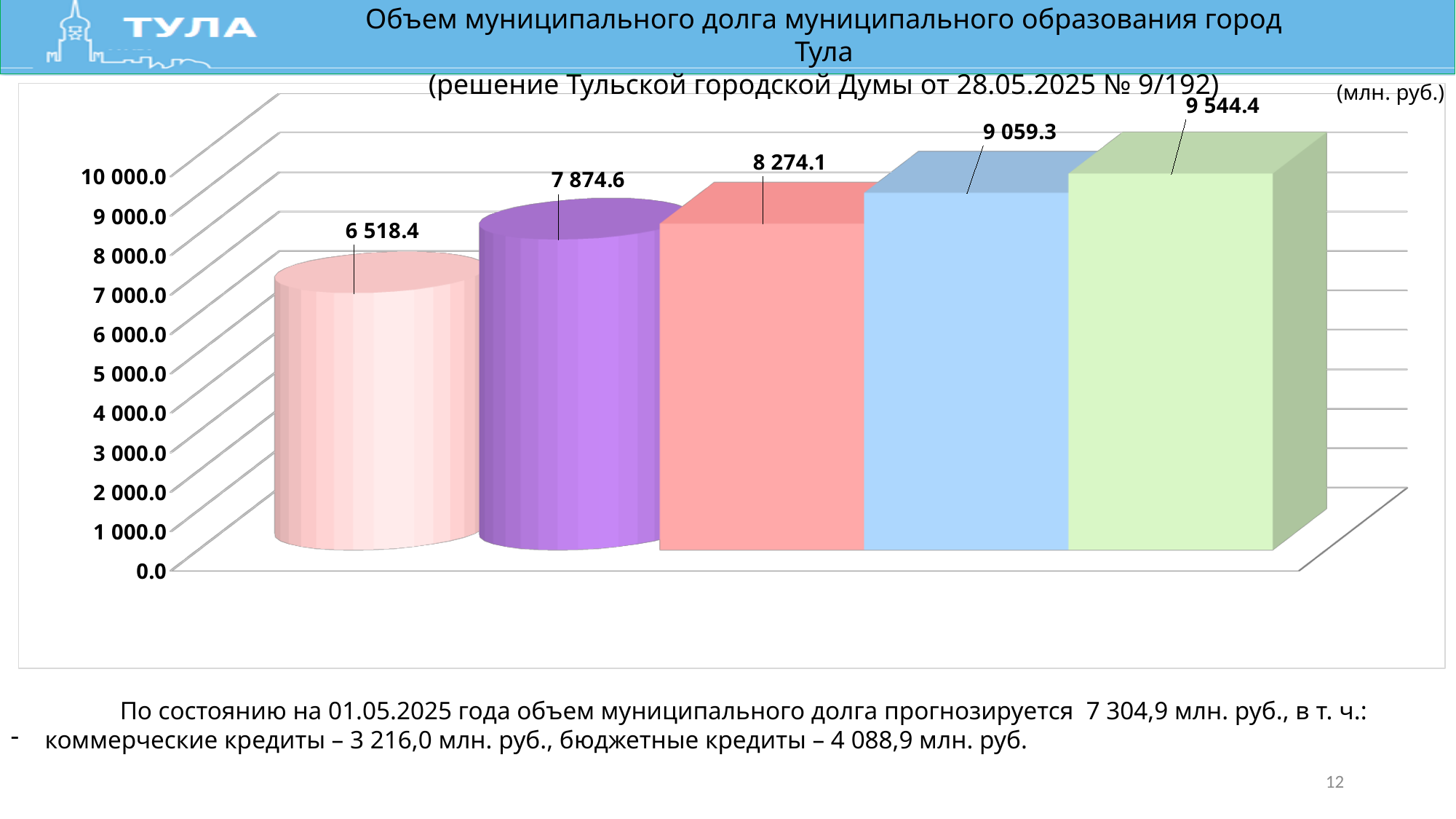
What value is printed on the first (leftmost, pink) bar? 6 518.4 What value is printed on the last (rightmost, green) bar? 9 544.4 What kind of chart is shown on the slide? Bar chart Which bar has the lowest value? The leftmost (pink) bar, 6 518.4 What is the difference between the green bar (9 544.4) and the pink bar (6 518.4)? 3 026.0 What value is printed on the purple bar? 7 874.6 What value is printed on the third (red) bar? 8 274.1 How many bars are plotted on the chart? 5 Which bar has the highest value? The rightmost (green) bar, 9 544.4 Do the values rise or fall from left to right across the chart? Rise Which is larger, the value of the purple bar or the value of the red bar? The red bar (8 274.1) What value is printed on the light blue bar? 9 059.3